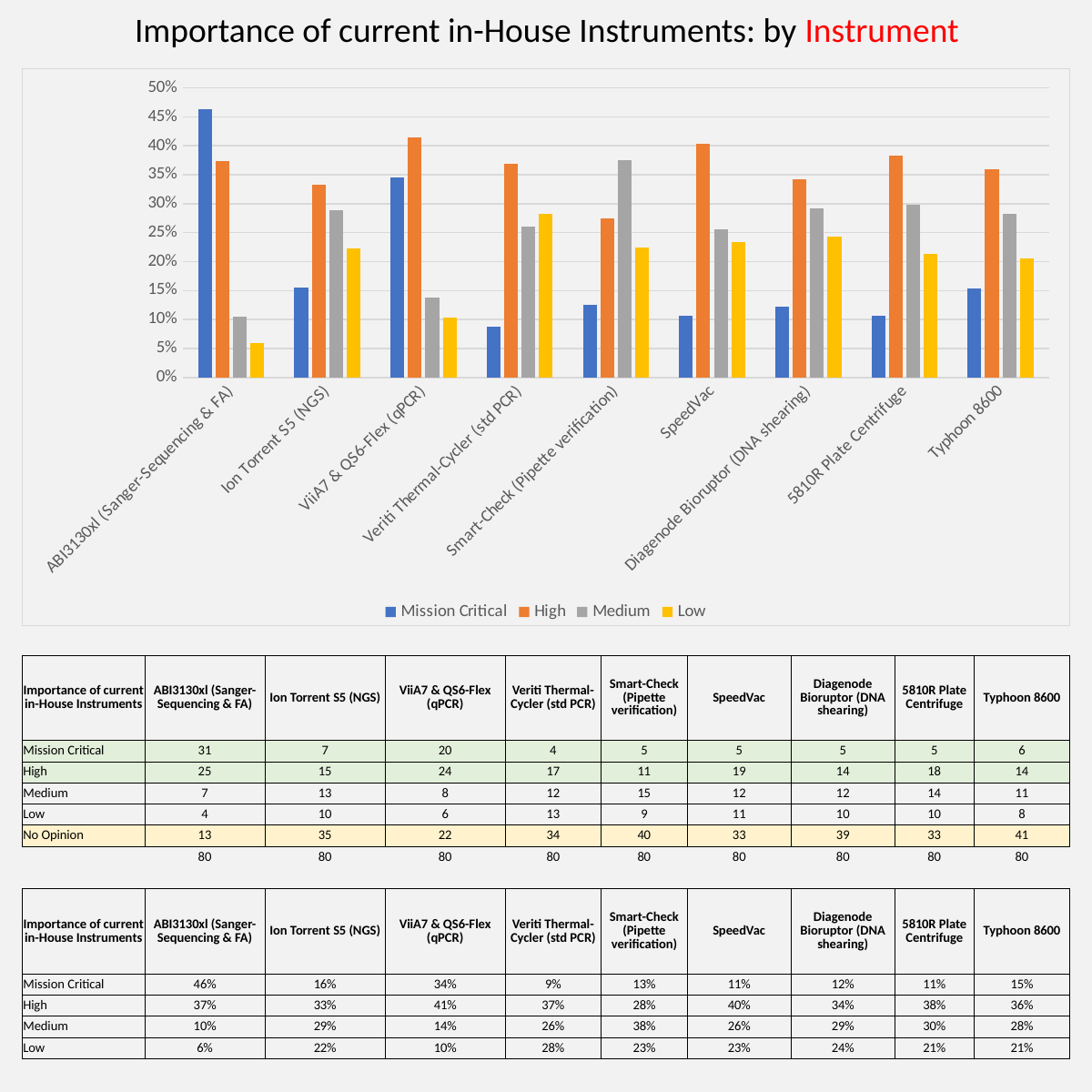
What is the difference between the High and Mission Critical values for Typhoon 8600? 21 percentage points Which instrument has the highest Medium value? Smart-Check (Pipette verification) Which instrument has the highest Mission Critical value? ABI3130xl (Sanger-Sequencing & FA) What is the High value for SpeedVac? 40% How many instruments are shown along the x axis of the chart? 9 Which instrument has the lowest Low value? ABI3130xl (Sanger-Sequencing & FA) How many series does the chart legend list? 4 Is the Low value for ABI3130xl (Sanger-Sequencing & FA) greater or less than 10%? less Which is larger, the Mission Critical value for ABI3130xl (Sanger-Sequencing & FA) or for ViiA7 & QS6-Flex (qPCR)? ABI3130xl (Sanger-Sequencing & FA) What type of chart is shown on the slide? Bar chart What is the Medium value for Smart-Check (Pipette verification)? 38% Is the Mission Critical value for Ion Torrent S5 (NGS) greater or less than 20%? less